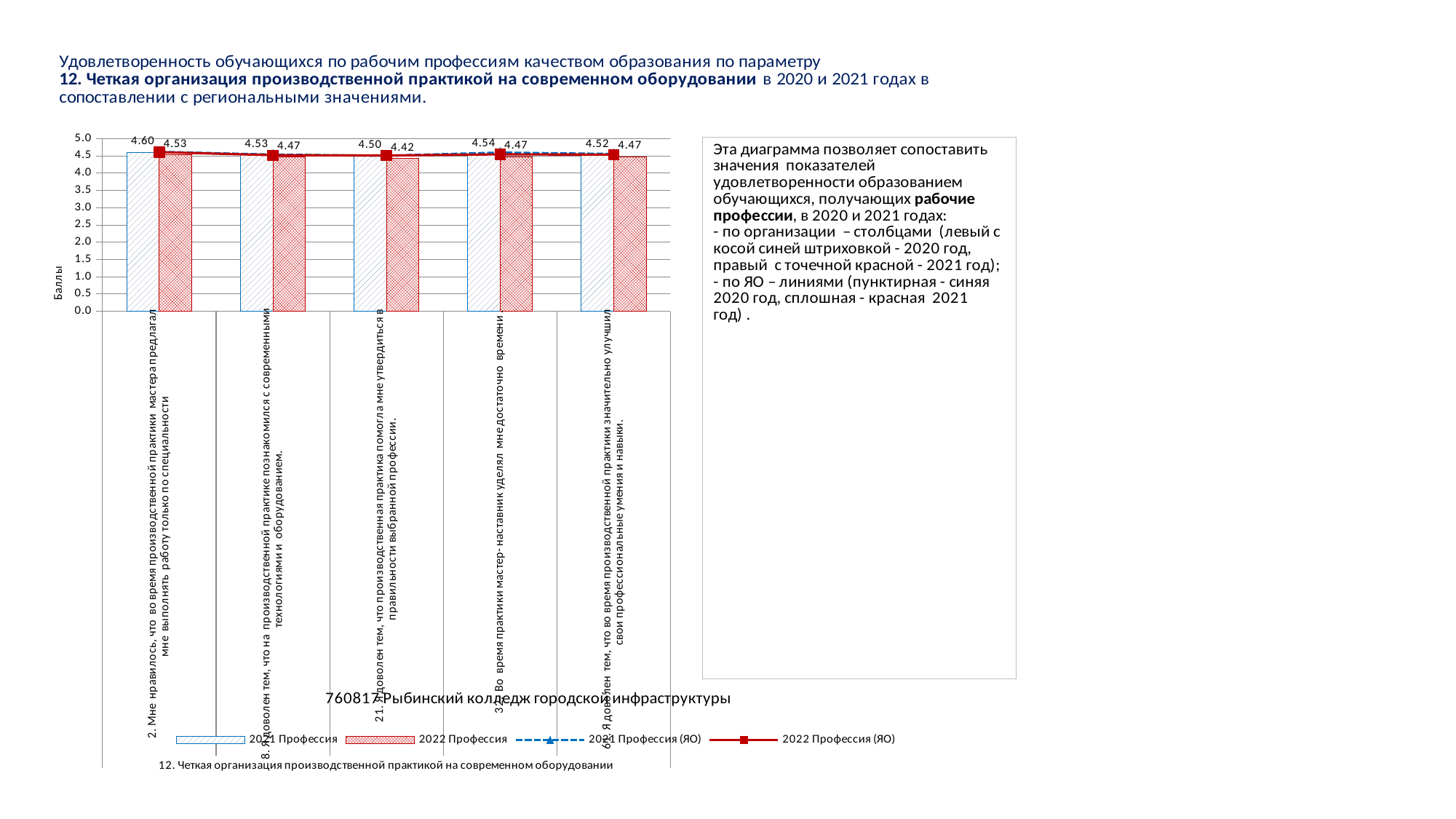
Which statement has the lowest 2022 Профессия value? Statement 21 (4.42) What is the title of the vertical axis of the chart? Баллы What kind of chart is shown on the slide? combination bar and line chart For statement 2, what is the difference between the 2021 Профессия value (4.60) and the 2022 Профессия value (4.53)? 0.07 What is the 2022 Профессия value for statement 21 (Я доволен тем, что производственная практика помогла мне утвердиться в правильности выбранной профессии)? 4.42 What is the 2021 Профессия value for statement 2 (Мне нравилось, что во время производственной практики мастер предлагал мне выполнять работу только по специальности)? 4.60 How many categories (survey statements) are plotted along the x axis of the chart? 5 How many series does the chart legend list? 4 Which statement has the highest 2021 Профессия value? Statement 2 (4.60) For statement 8, which is larger: the 2021 Профессия value or the 2022 Профессия value? 2021 Профессия (4.53)